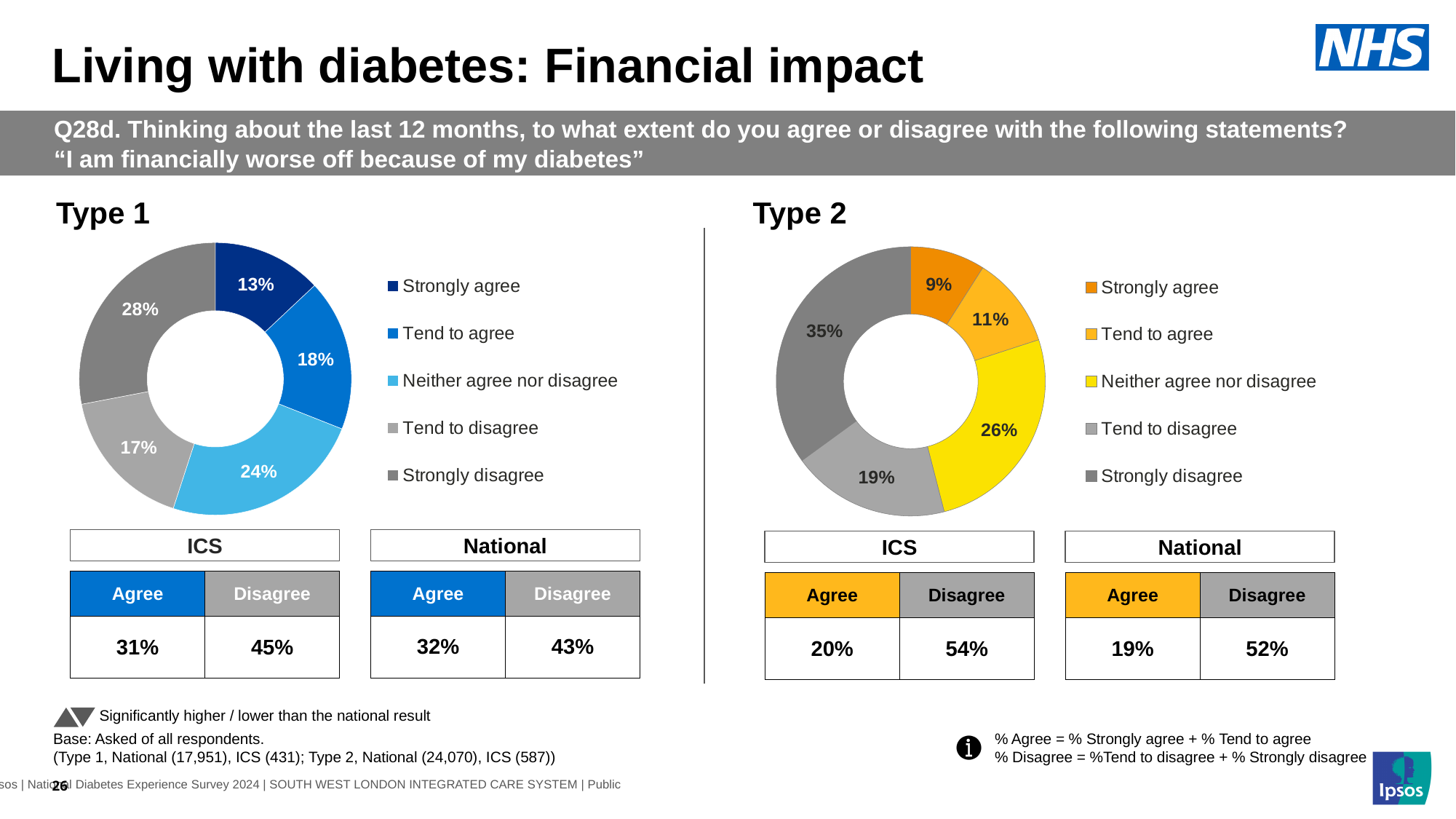
In the Type 2 chart, what is the combined share of Strongly agree and Tend to agree? 20% In the Type 2 chart, which response category has the smallest share? Strongly agree In the Type 1 chart, what is the combined share of Tend to disagree and Strongly disagree? 45% In the Type 1 chart, which response category has the largest share? Strongly disagree In the Type 2 chart, what percentage of respondents neither agree nor disagree? 26% What kind of chart is used for Type 2? Doughnut chart In the Type 2 chart, which is larger: Tend to disagree or Tend to agree? Tend to disagree In the Type 1 chart, what percentage of respondents strongly agree? 13% How many categories does the Type 1 chart's legend list? 5 In the Type 1 chart, what is the difference between the Neither agree nor disagree share and the Tend to agree share? 6 percentage points In the Type 1 chart, what colour is the Strongly agree segment? Dark blue In the Type 2 chart, what colour is the Neither agree nor disagree segment? Yellow